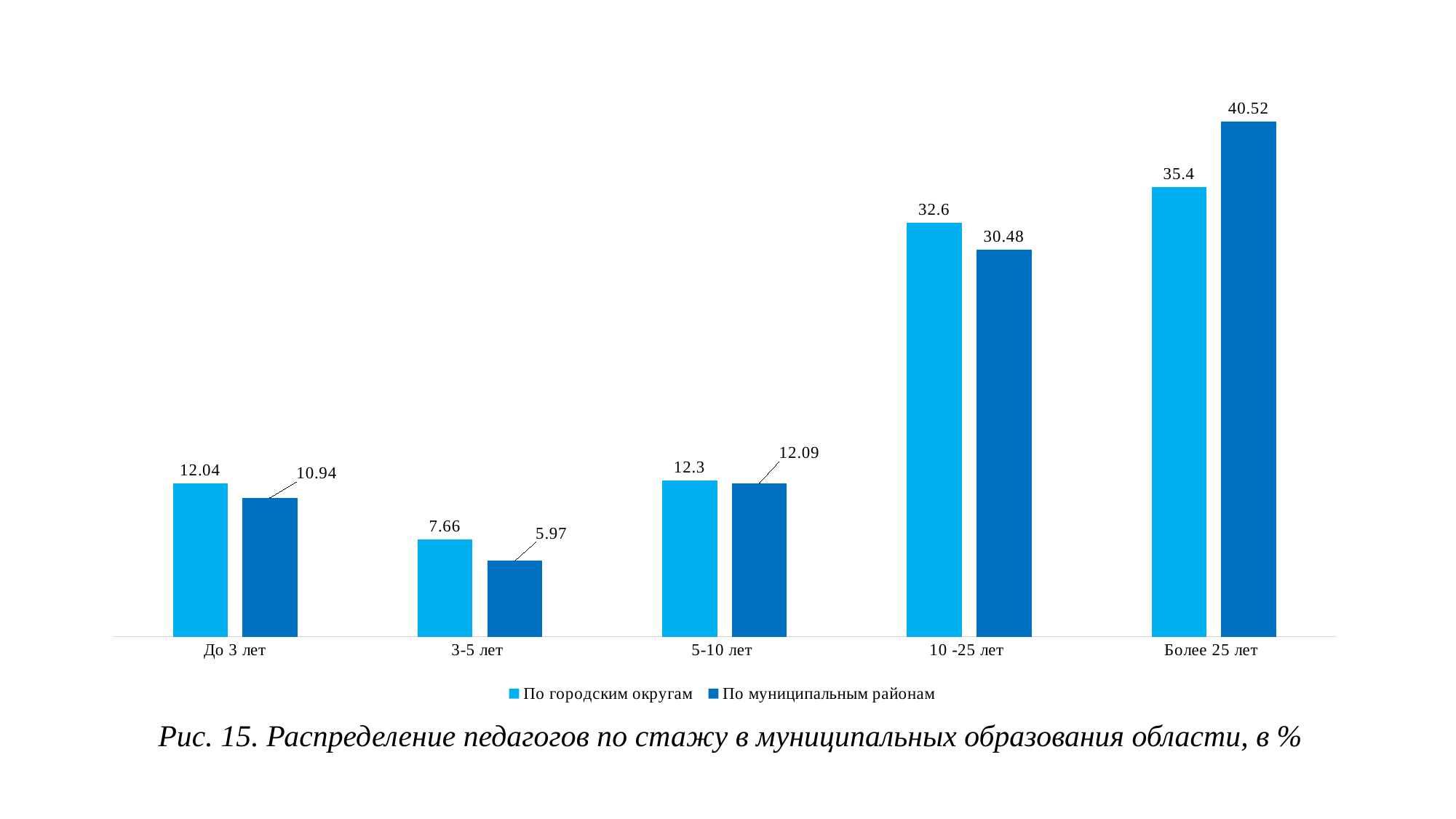
How many categories are shown on the x axis? 5 What is the caption of the figure shown on the slide? Рис. 15. Распределение педагогов по стажу в муниципальных образования области, в % Which category has the highest value for 'По городским округам'? Более 25 лет What is the value for 'По муниципальным районам' in the '3-5 лет' category? 5.97 What is the difference between 'По муниципальным районам' and 'По городским округам' in the 'Более 25 лет' category? 5.12 How many series does the legend list? 2 What is the value for 'По городским округам' in the 'До 3 лет' category? 12.04 What kind of chart is shown on the slide? Bar chart What is the value for 'По муниципальным районам' in the 'Более 25 лет' category? 40.52 In the '3-5 лет' category, which series has the larger value? По городским округам Which category has the lowest value for 'По муниципальным районам'? 3-5 лет What is the difference between 'По городским округам' and 'По муниципальным районам' in the '10 -25 лет' category? 2.12